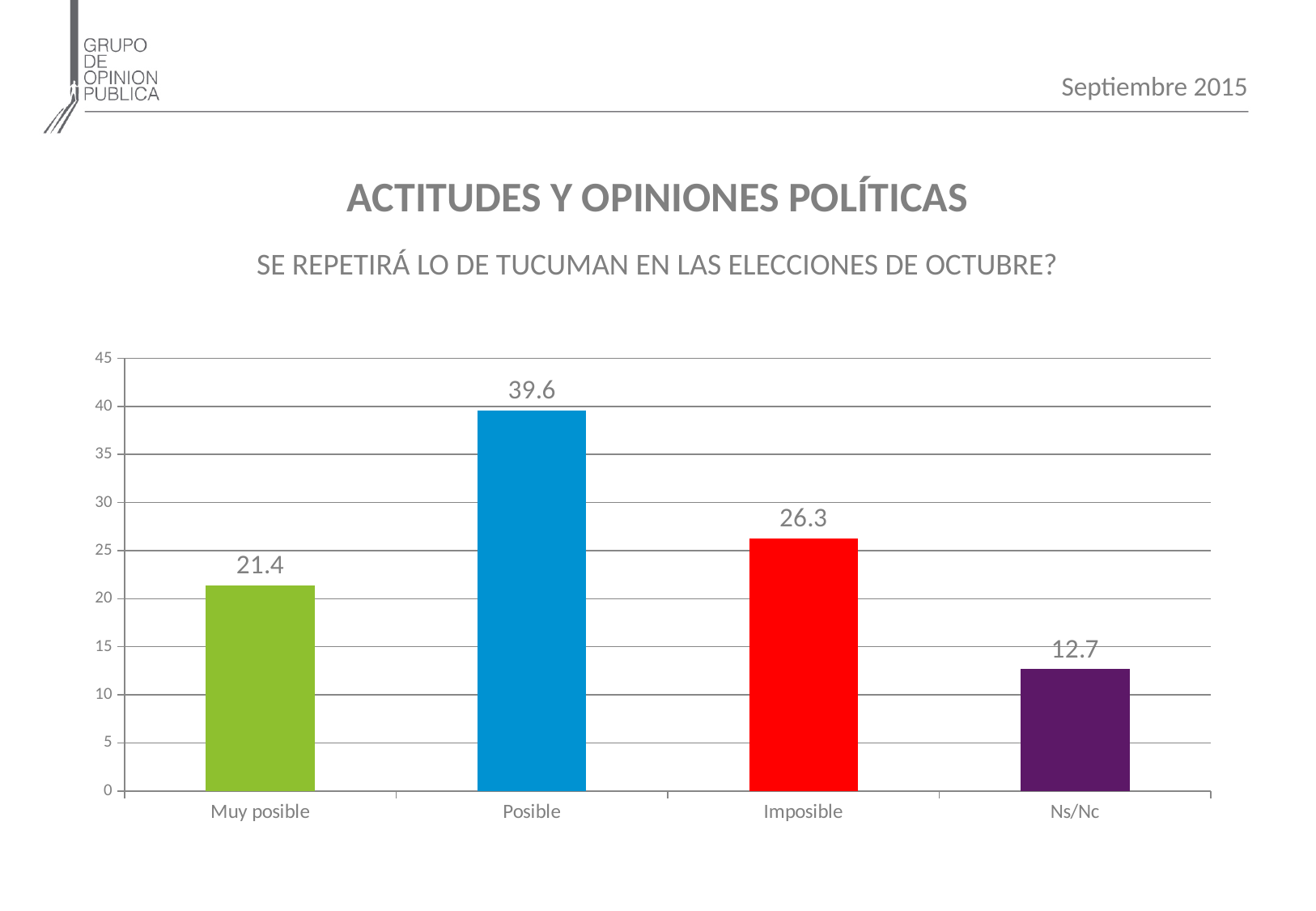
Which category has the lowest value? Ns/Nc What kind of chart is shown on the slide? bar chart What is the value for Muy posible? 21.4 What is the value for Posible? 39.6 Which is larger, the value for Imposible or the value for Muy posible? Imposible Which category has the highest value? Posible What is the value for Ns/Nc? 12.7 What is the difference between the values for Posible and Imposible? 13.3 Is the value for Imposible greater or less than 25? greater How many categories are shown on the x axis? 4 What is the difference between the values for Muy posible and Ns/Nc? 8.7 What is the value for Imposible? 26.3